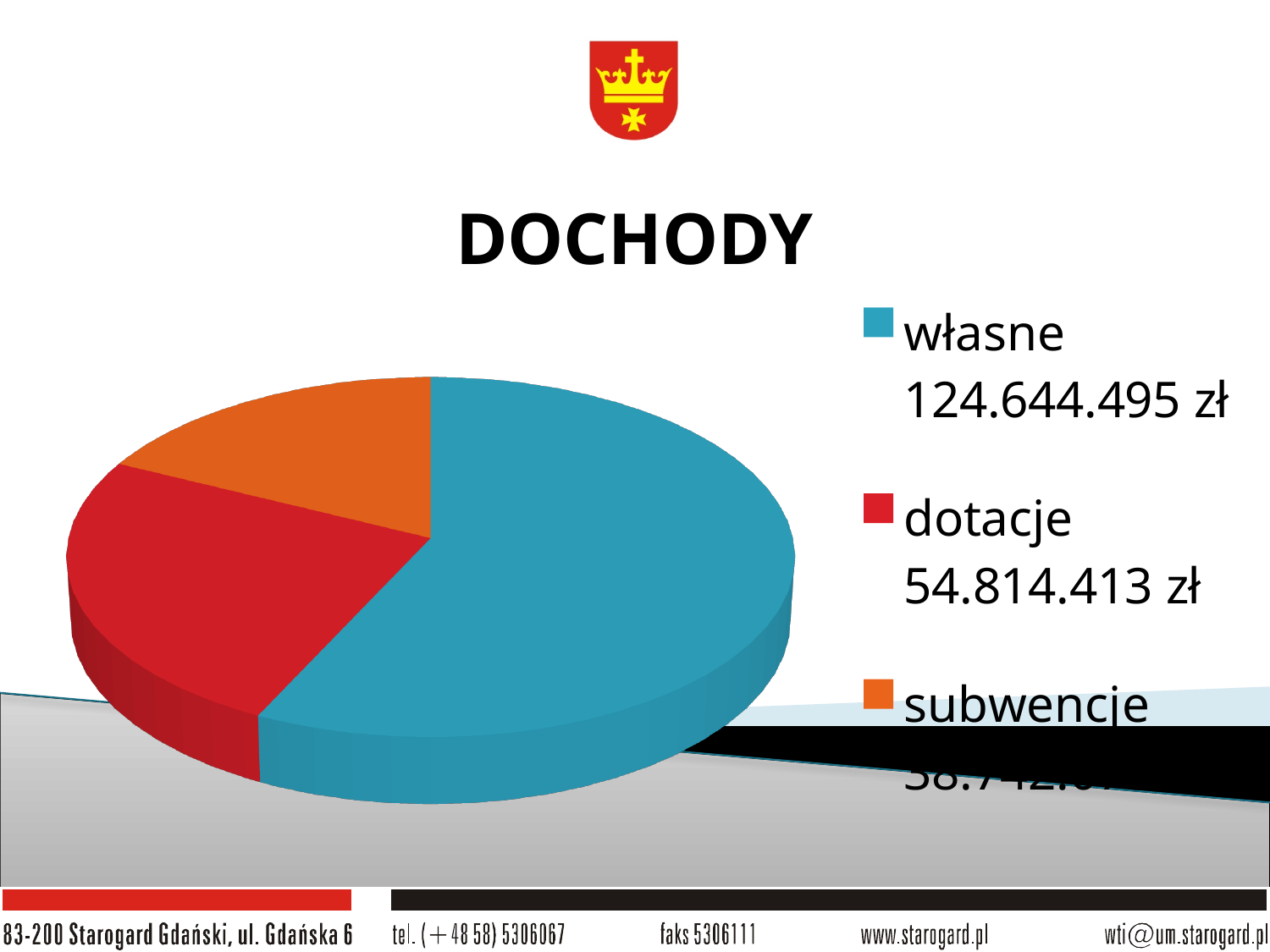
How many slices does the pie chart have? 3 Which category has the largest slice of the pie? własne How many entries does the legend list? 3 Which is larger, dotacje or subwencje? dotacje What is the value shown for własne? 124.644.495 zł What is the value shown for dotacje? 54.814.413 zł What is the difference between the values for własne and dotacje? 69.830.082 zł Which is larger, własne or dotacje? własne What kind of chart is shown on the slide? pie chart What is the title of the chart? DOCHODY What colour is the slice for własne? blue Which category has the smallest slice of the pie? subwencje